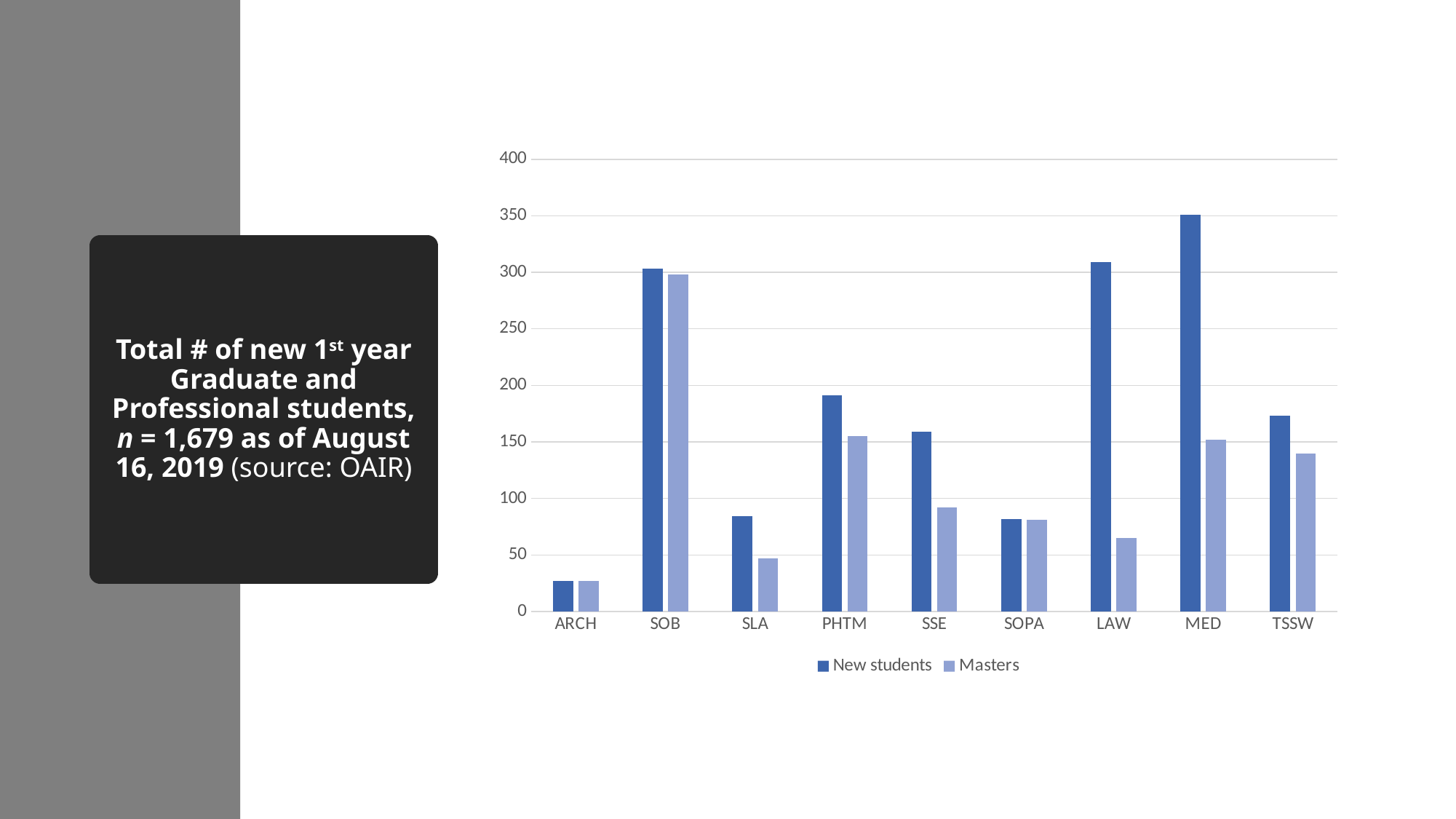
Which category has the lowest value for New students? ARCH Which category has the highest value for Masters? SOB Which category has the highest value for New students? MED What kind of chart is shown on the slide? bar chart How many series does the legend list? 2 Is the value for New students at SLA greater or less than 100? less What are the two series named in the legend? New students and Masters Is the value for New students at MED greater or less than 300? greater Is the value for Masters at SOB greater or less than 250? greater How many categories are shown on the x axis? 9 Which is larger at LAW, New students or Masters? New students